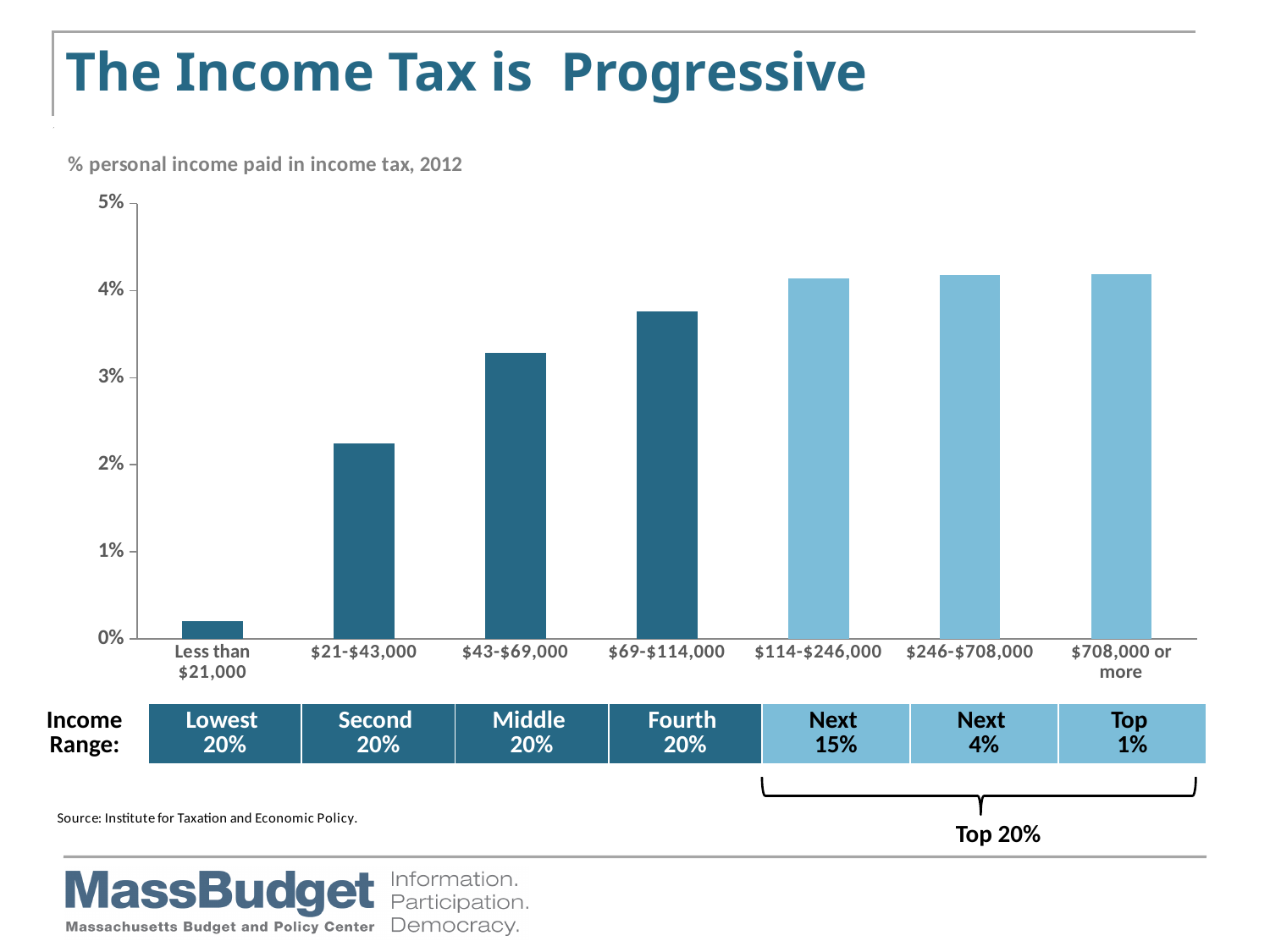
What source is cited for the chart data? Institute for Taxation and Economic Policy Is the value for the $21-$43,000 income range greater or less than 2%? greater What kind of chart is shown on the slide? bar chart How many income range categories are plotted in the chart? 7 Is the value for the $69-$114,000 income range greater or less than 4%? less Which income range has the lowest percentage of personal income paid in income tax? Less than $21,000 Do the values generally rise or fall as income range increases along the x axis? rise Is the value for the $114-$246,000 income range greater or less than 4%? greater Which is larger, the value for $43-$69,000 or the value for $21-$43,000? $43-$69,000 What is the subtitle describing the measure plotted in the chart? % personal income paid in income tax, 2012